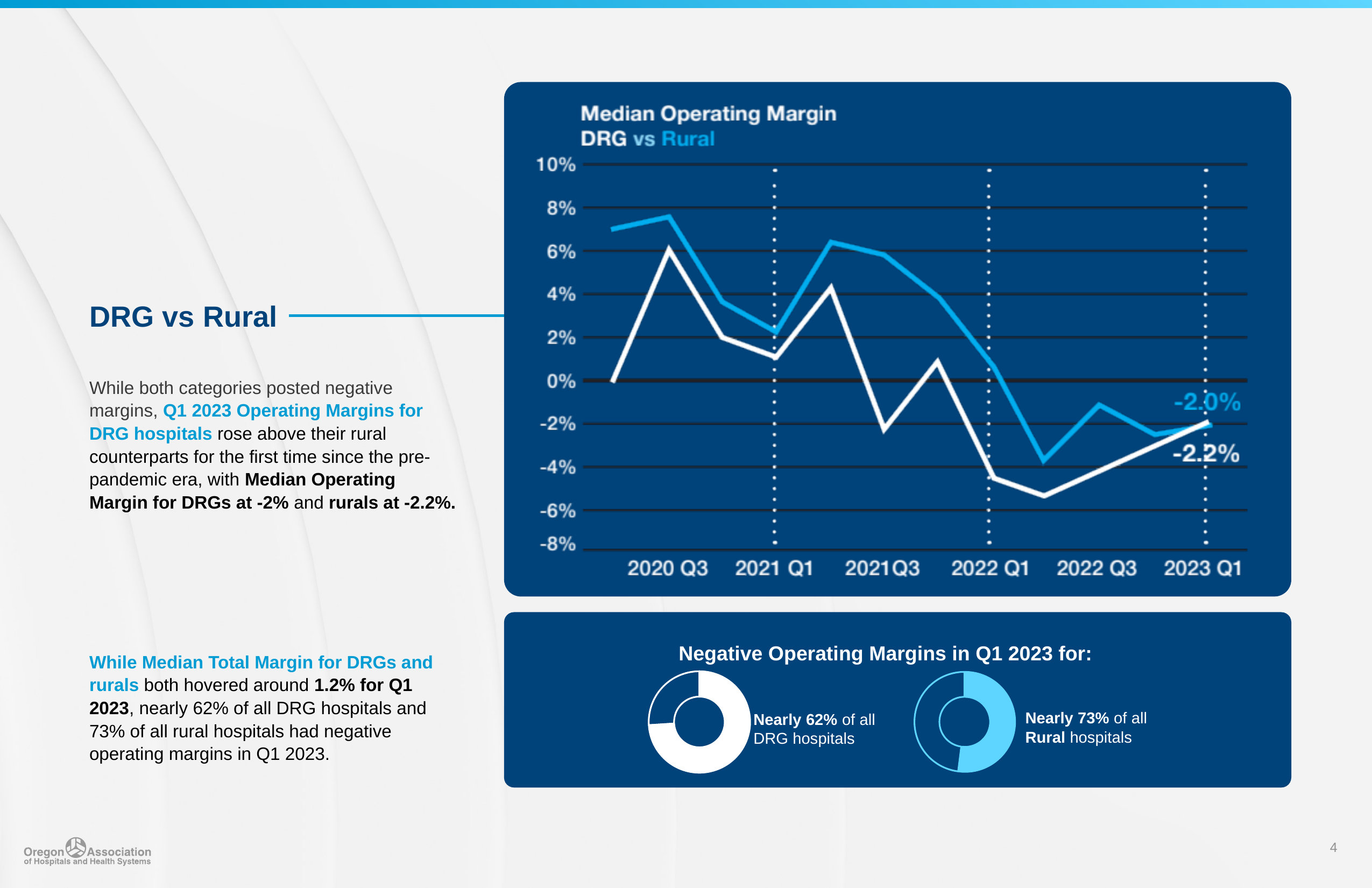
In the 'Median Operating Margin DRG vs Rural' chart, is the DRG value at 2022 Q1 greater or less than -2%? less In the 'Median Operating Margin DRG vs Rural' chart, is the Rural value at 2020 Q3 greater or less than 6%? greater In the 'Negative Operating Margins in Q1 2023 for:' donut charts, which group has the larger share with negative operating margins, DRG or Rural hospitals? Rural hospitals In the 'Median Operating Margin DRG vs Rural' chart, how many quarter labels are shown on the x axis? 6 In the 'Median Operating Margin DRG vs Rural' chart, how many series are plotted? 2 In the 'Negative Operating Margins in Q1 2023 for:' donut charts, what share of DRG hospitals had negative operating margins? Nearly 62% What kind of chart is the 'Median Operating Margin DRG vs Rural' chart? line chart In the 'Median Operating Margin DRG vs Rural' chart, does the Rural line overall rise or fall from 2020 Q3 to 2023 Q1? fall